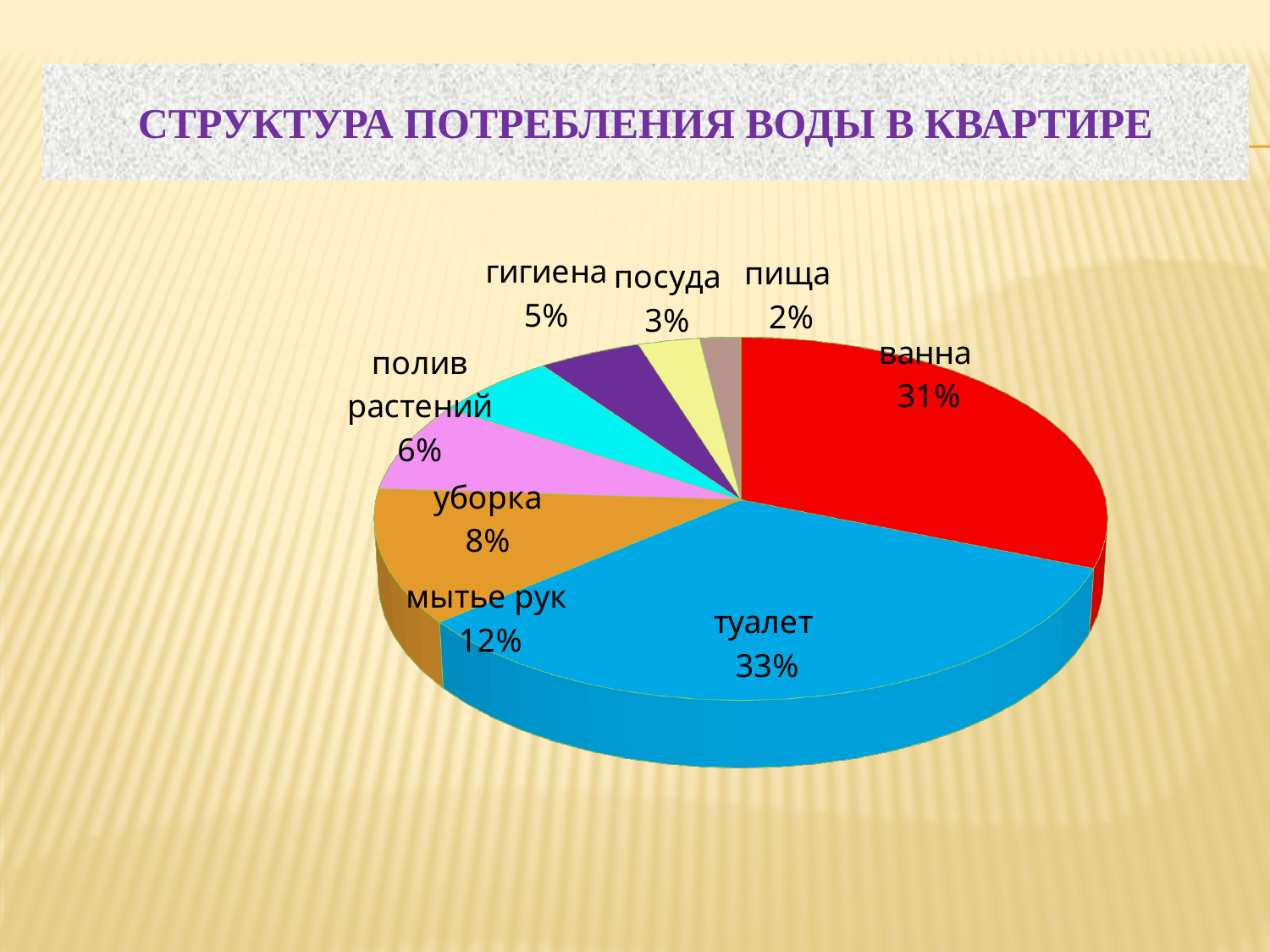
What is the difference in percentage points between туалет and ванна? 2 What percentage is shown for мытье рук? 12% What share of water consumption does туалет account for? 33% What is the difference in percentage points between мытье рук and уборка? 4 What type of chart is shown on the slide? pie chart Which category has the largest share of water consumption? туалет What share of water consumption does ванна account for? 31% How many categories are shown in the pie chart? 8 Which has a larger share, гигиена or посуда? гигиена What is the title of the chart on the slide? СТРУКТУРА ПОТРЕБЛЕНИЯ ВОДЫ В КВАРТИРЕ What percentage is shown for полив растений? 6% Which category has the smallest share of water consumption? пища